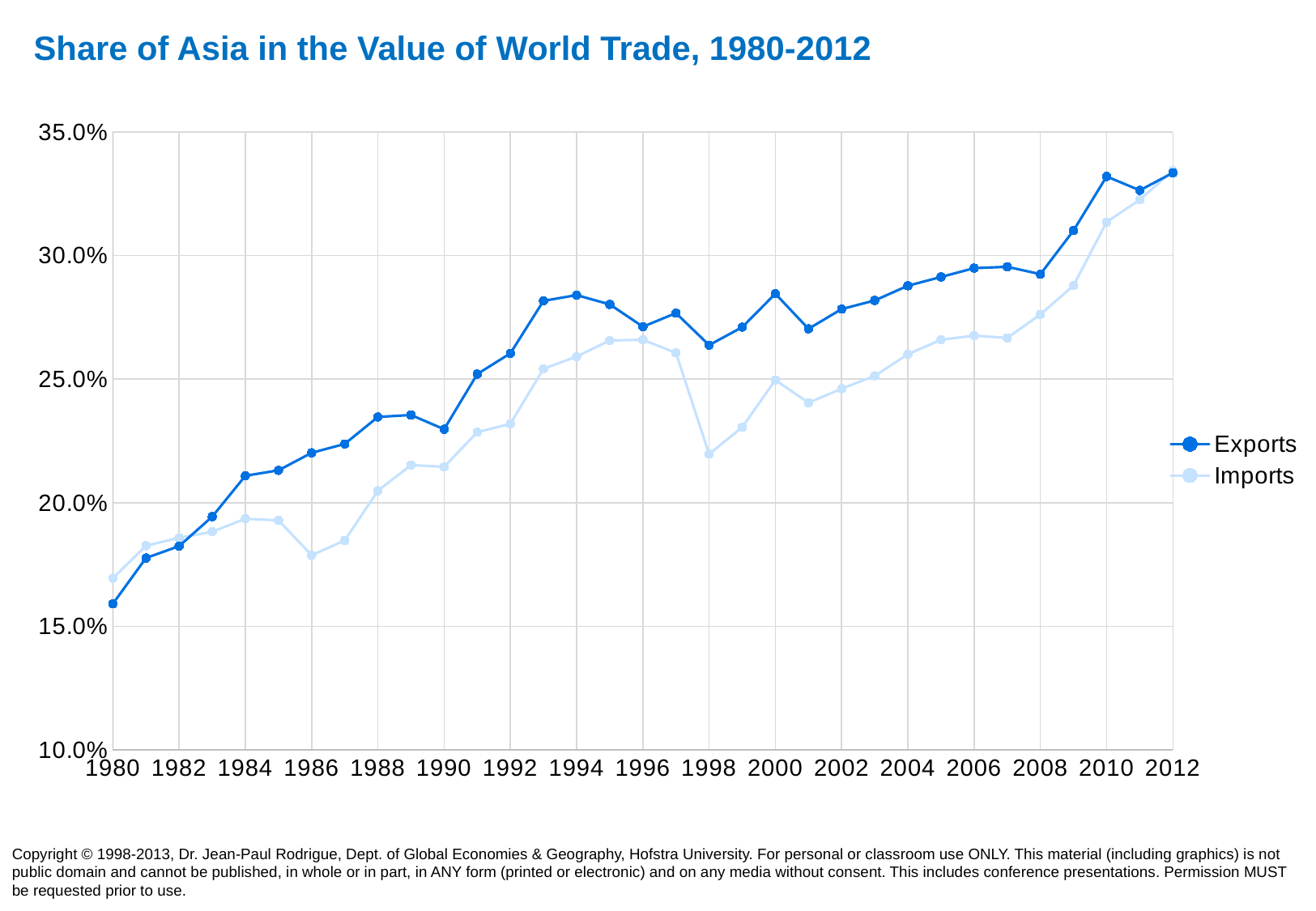
What is the title of the chart? Share of Asia in the Value of World Trade, 1980-2012 Is the Imports value for 2010 greater or less than 30.0%? greater In 2000, which series has the higher value, Exports or Imports? Exports How many series does the legend list? 2 Overall, do the Exports values rise or fall from 1980 to 2012? rise Is the Exports value for 2012 greater or less than 30.0%? greater Is the Exports value for 1980 greater or less than 20.0%? less In which year is the Exports value lowest? 1980 In 1980, which series has the higher value, Exports or Imports? Imports What kind of chart is shown on the slide? line chart What are the two series shown in the legend? Exports and Imports